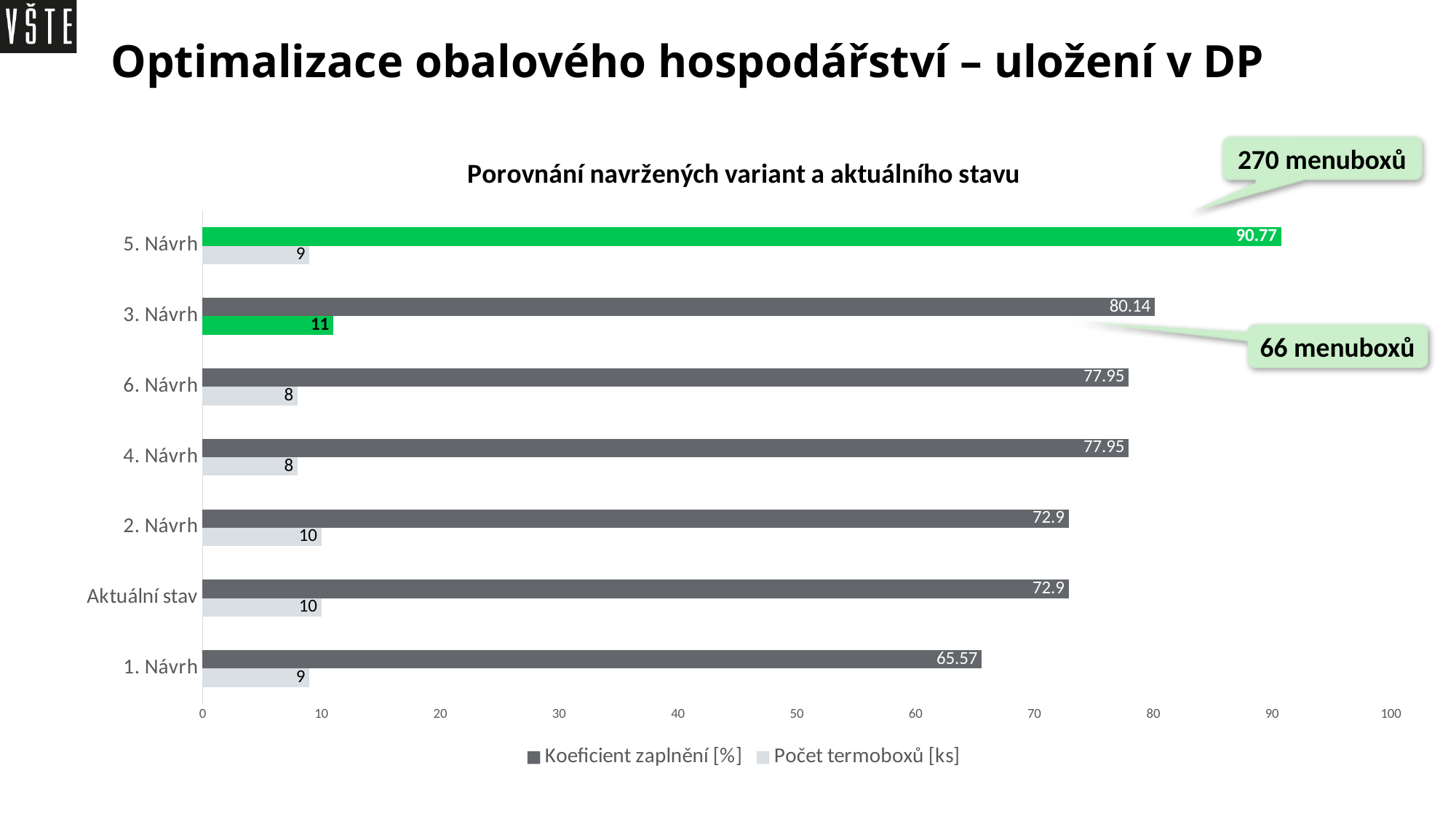
What is the Počet termoboxů [ks] value for 3. Návrh? 11 What is the title of the chart? Porovnání navržených variant a aktuálního stavu Which has a larger Počet termoboxů [ks], 3. Návrh or 6. Návrh? 3. Návrh What is the Koeficient zaplnění [%] value for Aktuální stav? 72.9 What is the Koeficient zaplnění [%] value for 5. Návrh? 90.77 Which category has the lowest Koeficient zaplnění [%]? 1. Návrh How many series does the legend list? 2 What is the difference in Koeficient zaplnění [%] between 5. Návrh and 3. Návrh? 10.63 What is the Počet termoboxů [ks] value for 4. Návrh? 8 How many categories are shown on the chart? 7 Which category has the highest Koeficient zaplnění [%]? 5. Návrh What kind of chart is shown on the slide? Bar chart